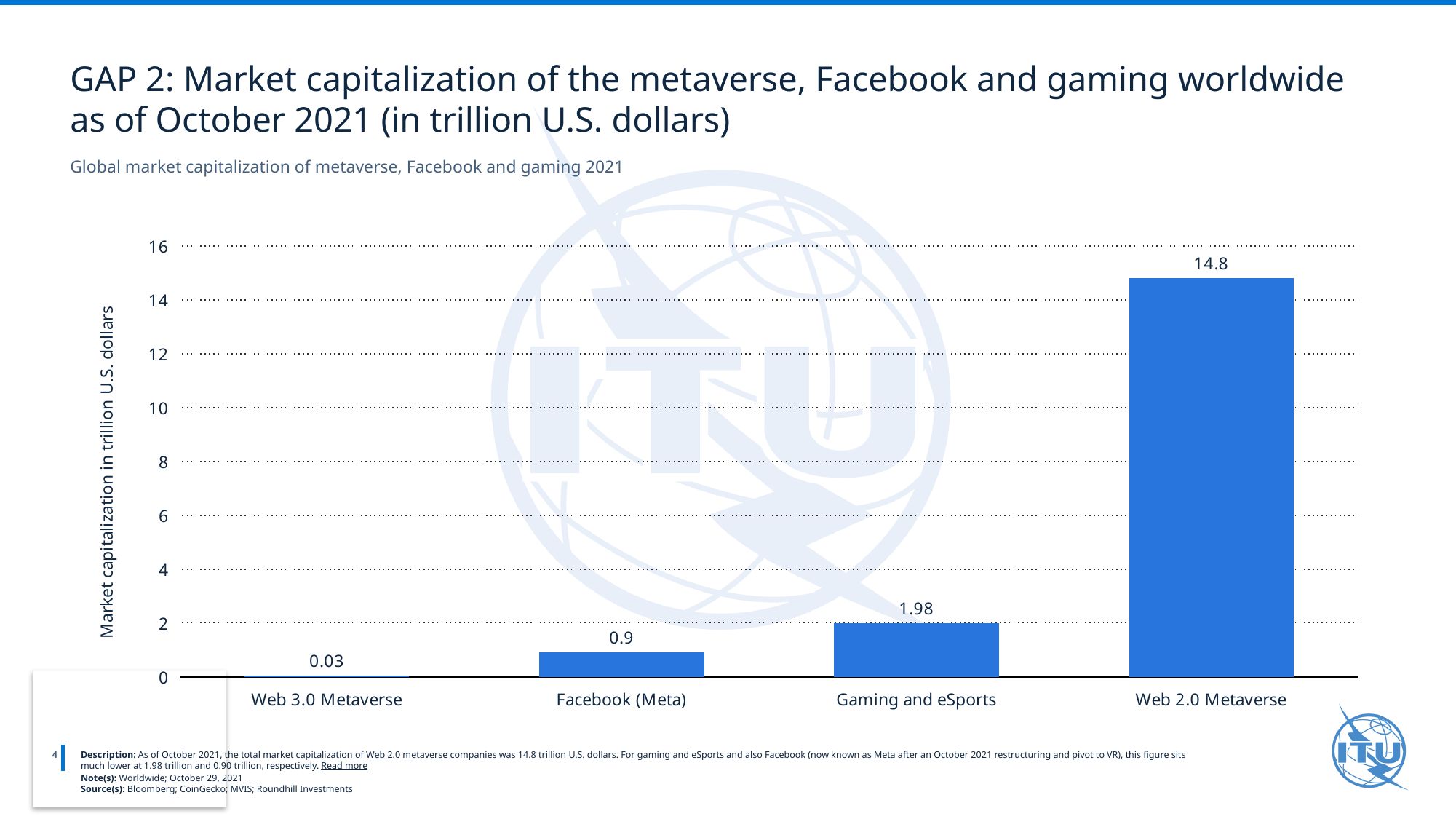
What kind of chart is shown on the slide? Bar chart What is the market capitalization shown for Gaming and eSports? 1.98 What is the market capitalization shown for Web 2.0 Metaverse? 14.8 What is the market capitalization shown for Web 3.0 Metaverse? 0.03 How many categories are shown on the x axis? 4 What is the label of the vertical axis? Market capitalization in trillion U.S. dollars Which is larger, the market capitalization of Facebook (Meta) or Gaming and eSports? Gaming and eSports What is the difference between the market capitalization of Web 2.0 Metaverse and Gaming and eSports? 12.82 What is the market capitalization shown for Facebook (Meta)? 0.9 What is the difference between the market capitalization of Gaming and eSports and Facebook (Meta)? 1.08 Which category has the lowest market capitalization? Web 3.0 Metaverse Which category has the highest market capitalization? Web 2.0 Metaverse